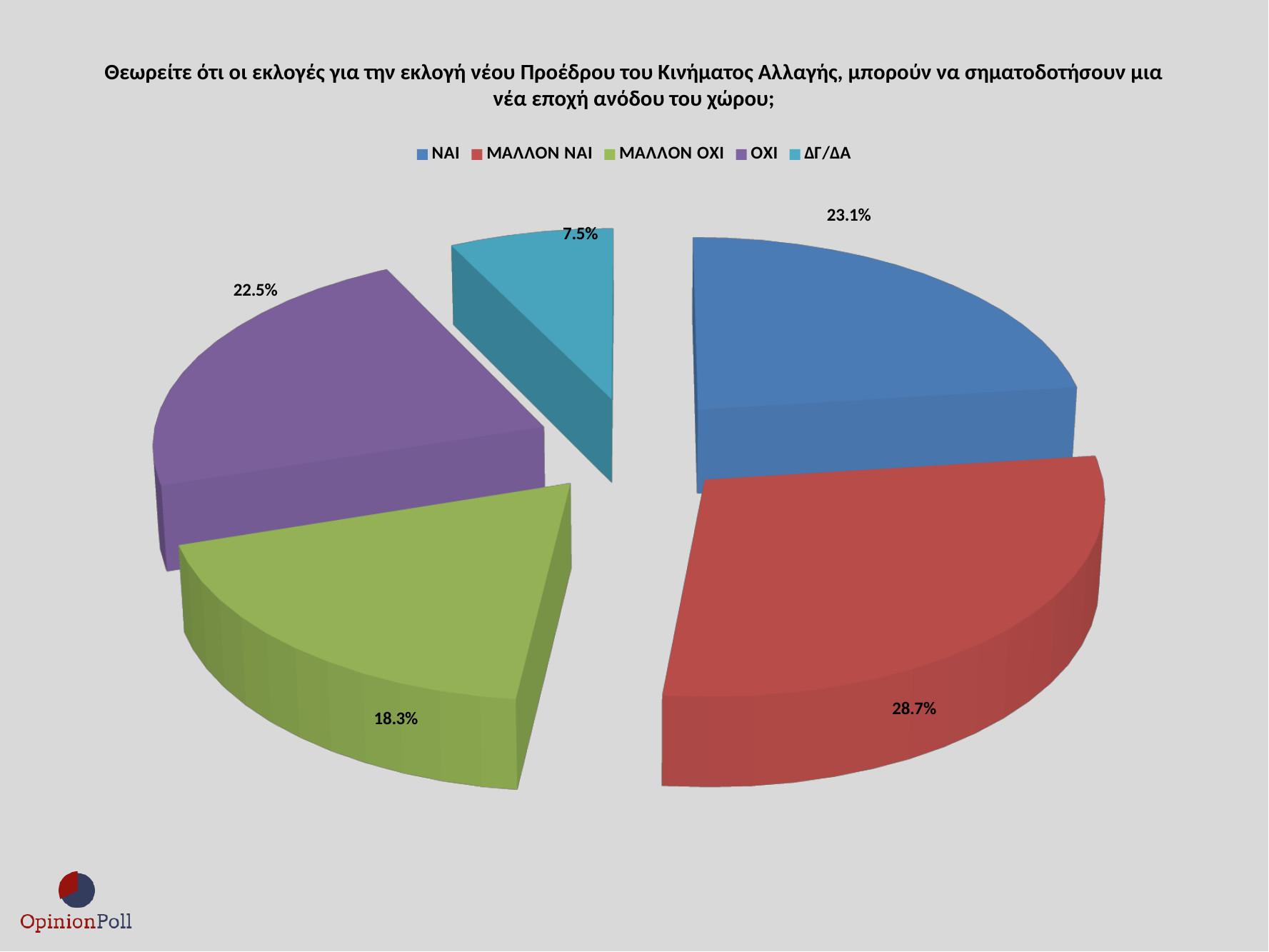
Which colour represents ΟΧΙ in the legend? Purple What kind of chart is shown on the slide? Pie chart What percentage of respondents answered ΜΑΛΛΟΝ ΝΑΙ? 28.7% Which response has the smallest share of the pie? ΔΓ/ΔΑ What percentage of respondents answered ΟΧΙ? 22.5% What is the difference in percentage points between ΜΑΛΛΟΝ ΝΑΙ and ΝΑΙ? 5.6 What percentage of respondents answered ΜΑΛΛΟΝ ΟΧΙ? 18.3% What percentage of respondents answered ΔΓ/ΔΑ? 7.5% What percentage of respondents answered ΝΑΙ? 23.1% How many slices does the pie chart have? 5 Which response has the largest share of the pie? ΜΑΛΛΟΝ ΝΑΙ Which is larger, the share for ΟΧΙ or the share for ΜΑΛΛΟΝ ΟΧΙ? ΟΧΙ